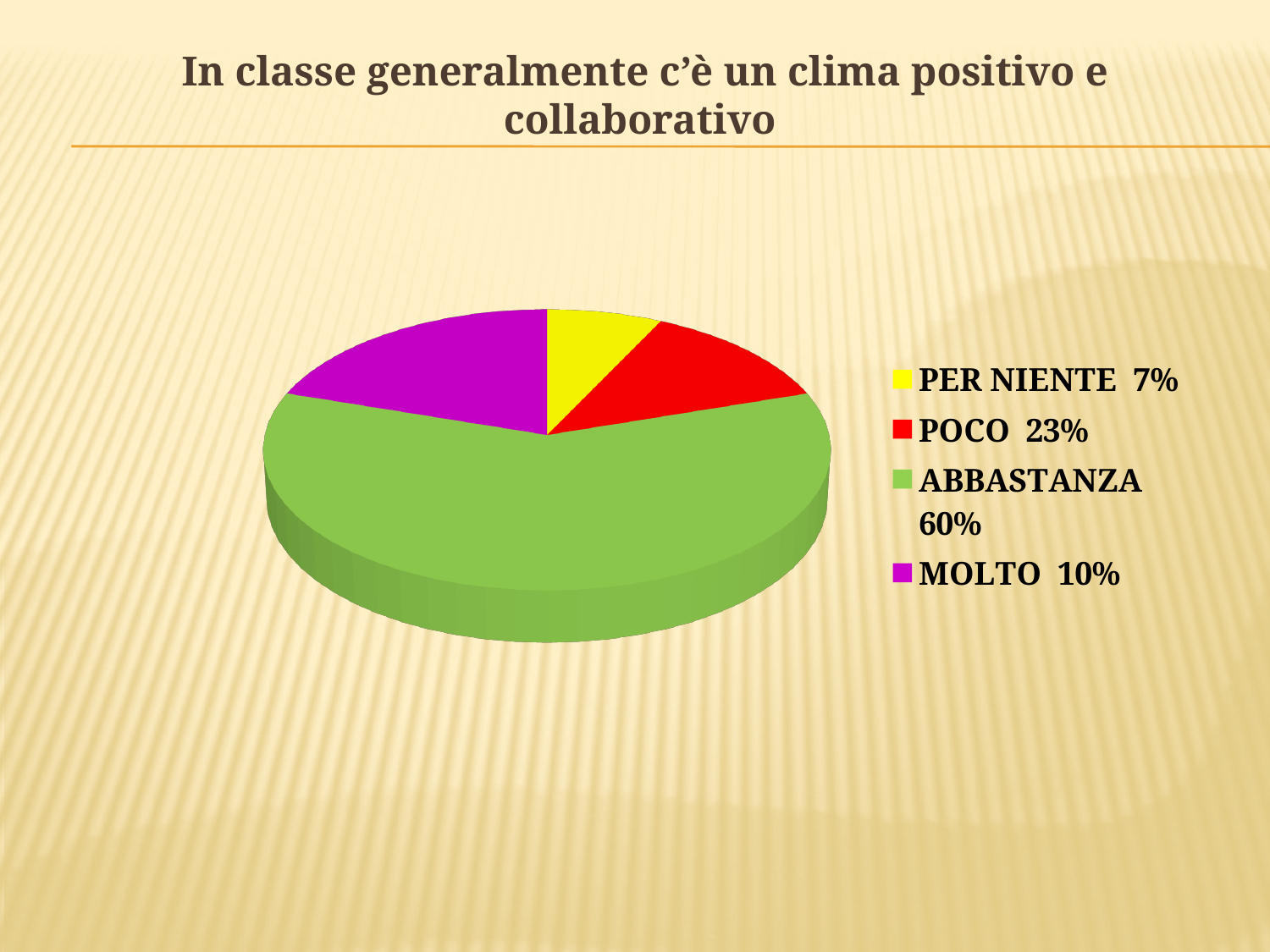
What is the difference between the shares for ABBASTANZA and POCO? 37% What colour is the slice for MOLTO? purple What is the value for PER NIENTE? 7% What share of the pie does ABBASTANZA represent? 60% What is the title of the slide containing the pie chart? In classe generalmente c'è un clima positivo e collaborativo Which category has the smallest share of the pie? PER NIENTE What kind of chart is shown on the slide? pie chart What is the value for POCO? 23% How many categories does the pie chart have? 4 Which category has the largest share of the pie? ABBASTANZA What is the value for MOLTO? 10%